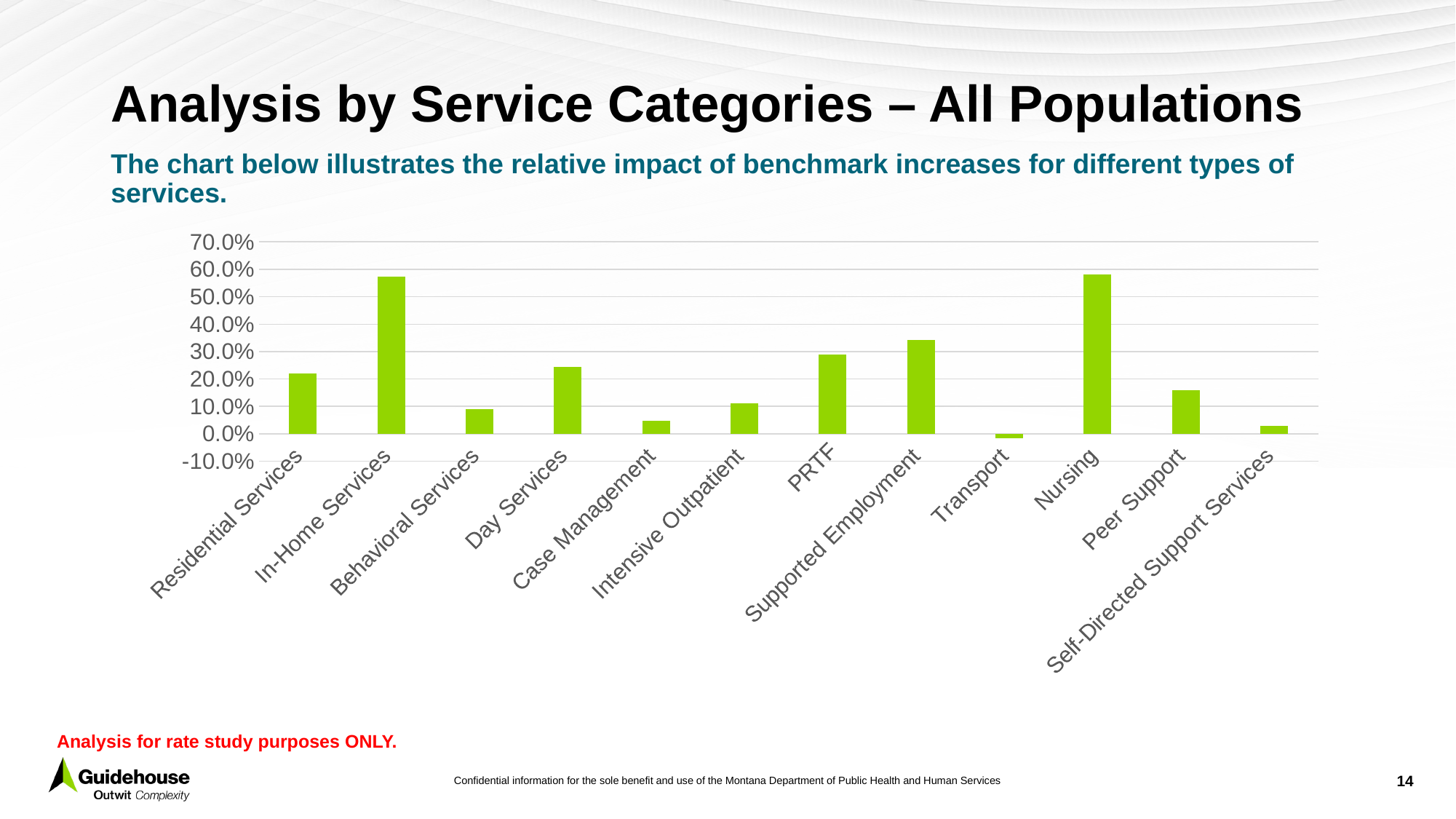
Is the value for Peer Support greater or less than 20.0%? less Is the value for Supported Employment greater or less than 30.0%? greater Which has a larger value, PRTF or Intensive Outpatient? PRTF Which has a larger value, Residential Services or Self-Directed Support Services? Residential Services What is the highest value shown on the vertical axis of the chart? 70.0% Is the value for In-Home Services greater or less than 50.0%? greater Which service category has the lowest value on the chart? Transport What kind of chart is shown on the slide? bar chart How many service categories are plotted on the chart? 12 Which has a larger value, Day Services or Case Management? Day Services